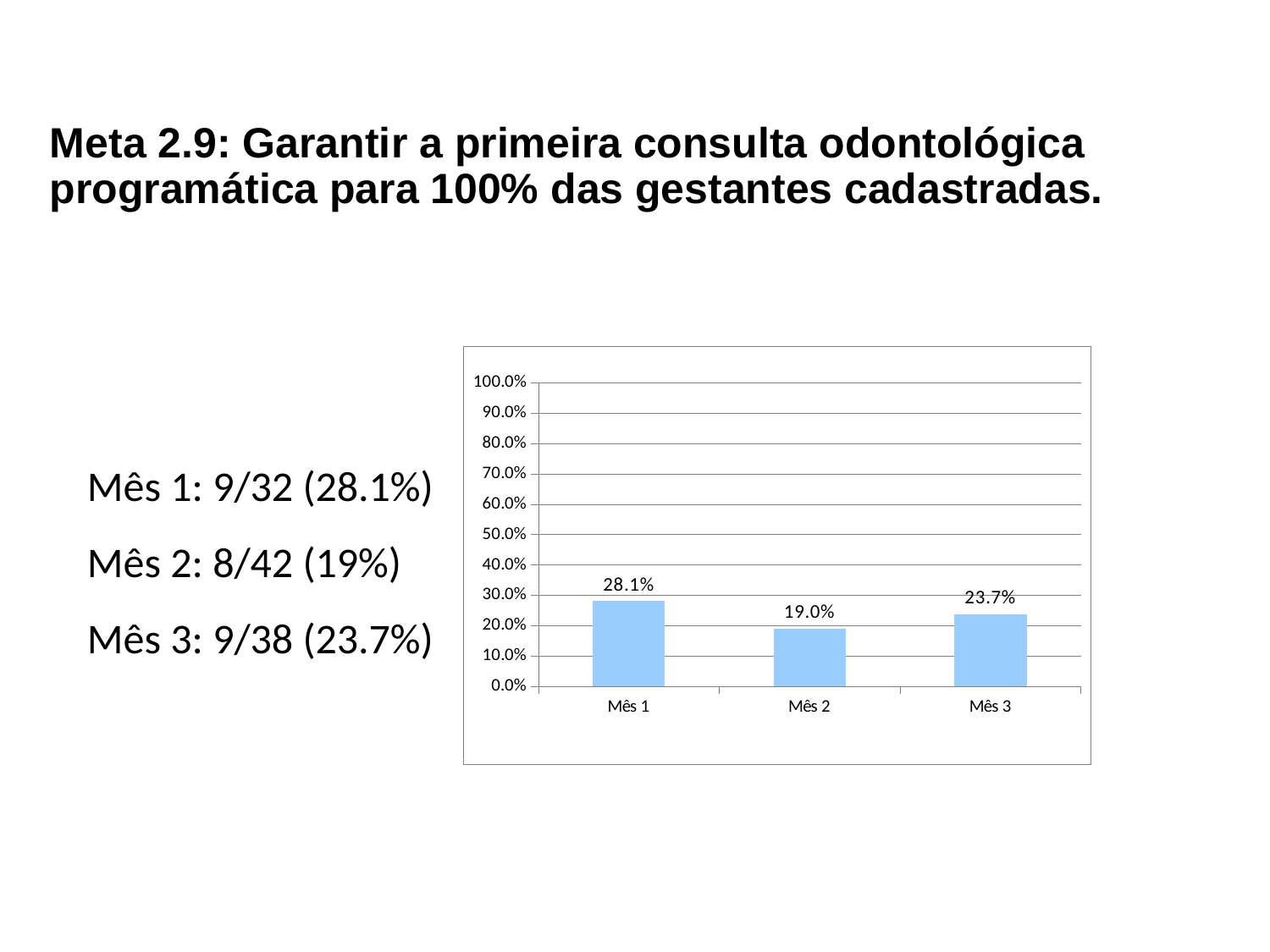
How many categories are shown on the x axis? 3 What is the value for Mês 1? 28.1% What is the highest value shown on the y axis? 100.0% Which category has the lowest value? Mês 2 What is the difference between the values for Mês 3 and Mês 2? 4.7% What is the value for Mês 3? 23.7% What is the difference between the values for Mês 1 and Mês 2? 9.1% What is the value for Mês 2? 19.0% Is the value for Mês 2 greater or less than 20.0%? less Which is larger, the value for Mês 1 or the value for Mês 3? Mês 1 Which category has the highest value? Mês 1 What kind of chart is shown on the slide? bar chart